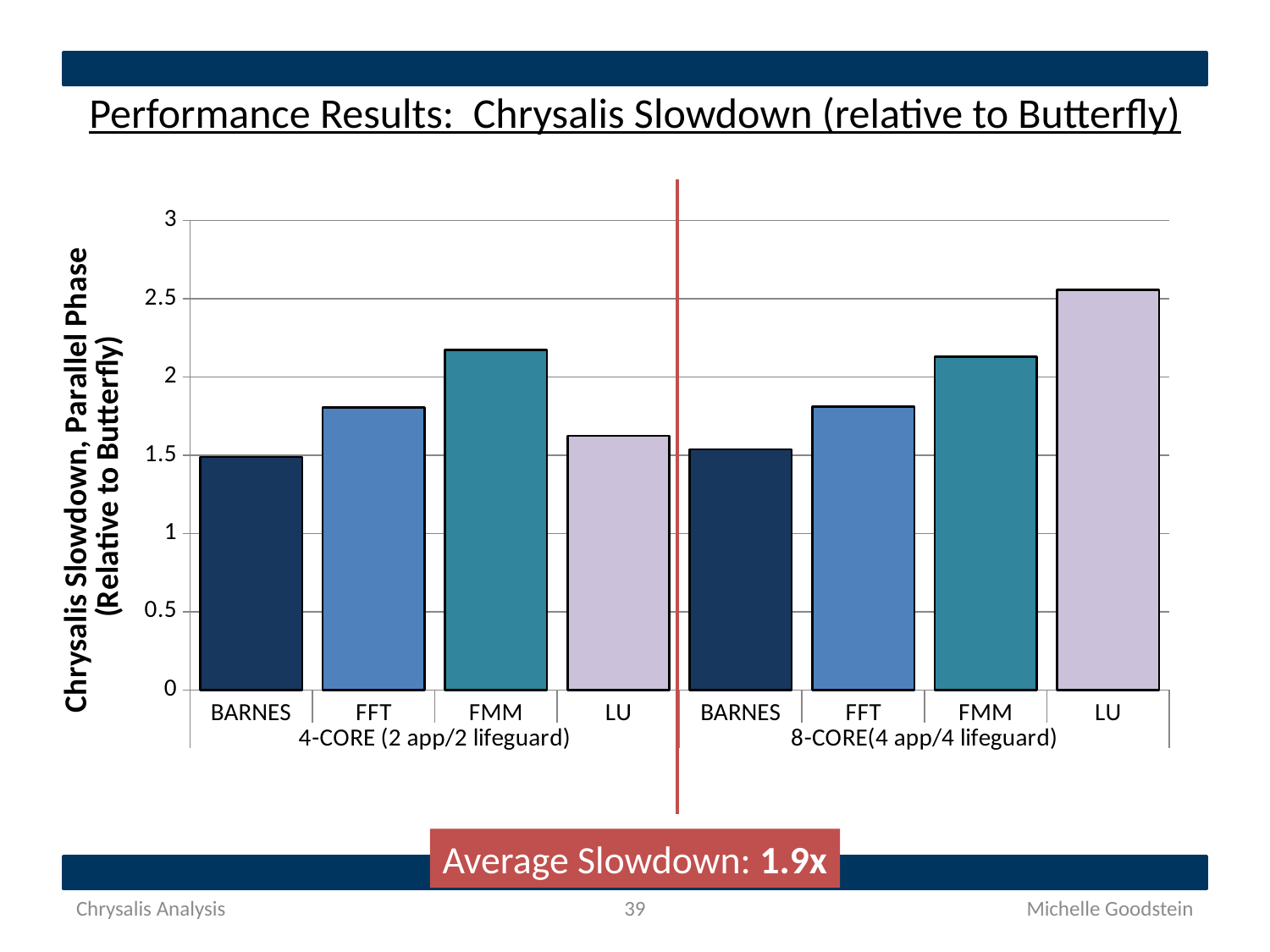
Which benchmark has the highest Chrysalis slowdown across both core configurations? LU (8-CORE) Is the slowdown for FMM in the 4-CORE group greater or less than 2? greater Within the 4-CORE (2 app/2 lifeguard) group, which benchmark has the lowest slowdown? BARNES Within the 4-CORE (2 app/2 lifeguard) group, which benchmark has the highest slowdown? FMM How many bars are plotted in the chart? 8 Which is larger: the slowdown for LU in the 4-CORE group or LU in the 8-CORE group? LU in the 8-CORE group Within the 8-CORE (4 app/4 lifeguard) group, which benchmark has the lowest slowdown? BARNES What is the label of the vertical axis? Chrysalis Slowdown, Parallel Phase (Relative to Butterfly) Is the slowdown for LU in the 4-CORE group greater or less than 1.5? greater What kind of chart is shown on the slide? bar chart Is the slowdown for LU in the 8-CORE group greater or less than 2? greater